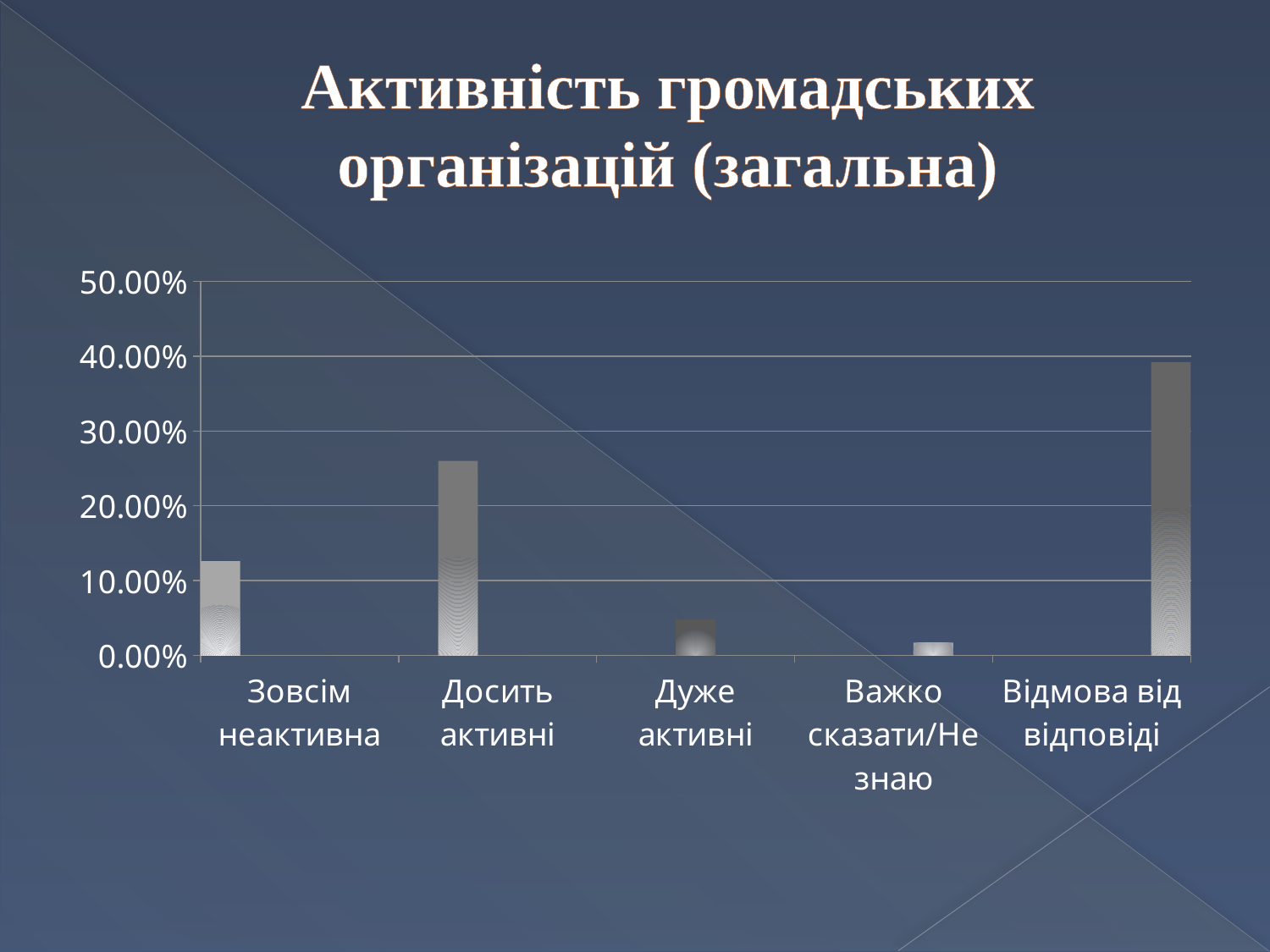
Which is larger, the value for Дуже активні or the value for Важко сказати/Не знаю? Дуже активні Is the value for Дуже активні greater or less than 10.00%? less Is the value for Зовсім неактивна greater or less than 20.00%? less How many categories are shown on the x axis of the chart? 5 Is the value for Досить активні greater or less than 20.00%? greater What is the title of the chart? Активність громадських організацій (загальна) Which is larger, the value for Досить активні or the value for Зовсім неактивна? Досить активні Which category has the lowest bar? Важко сказати/Не знаю What is the highest value shown on the y axis of the chart? 50.00% What kind of chart is shown on the slide? bar chart Which category has the highest bar? Відмова від відповіді